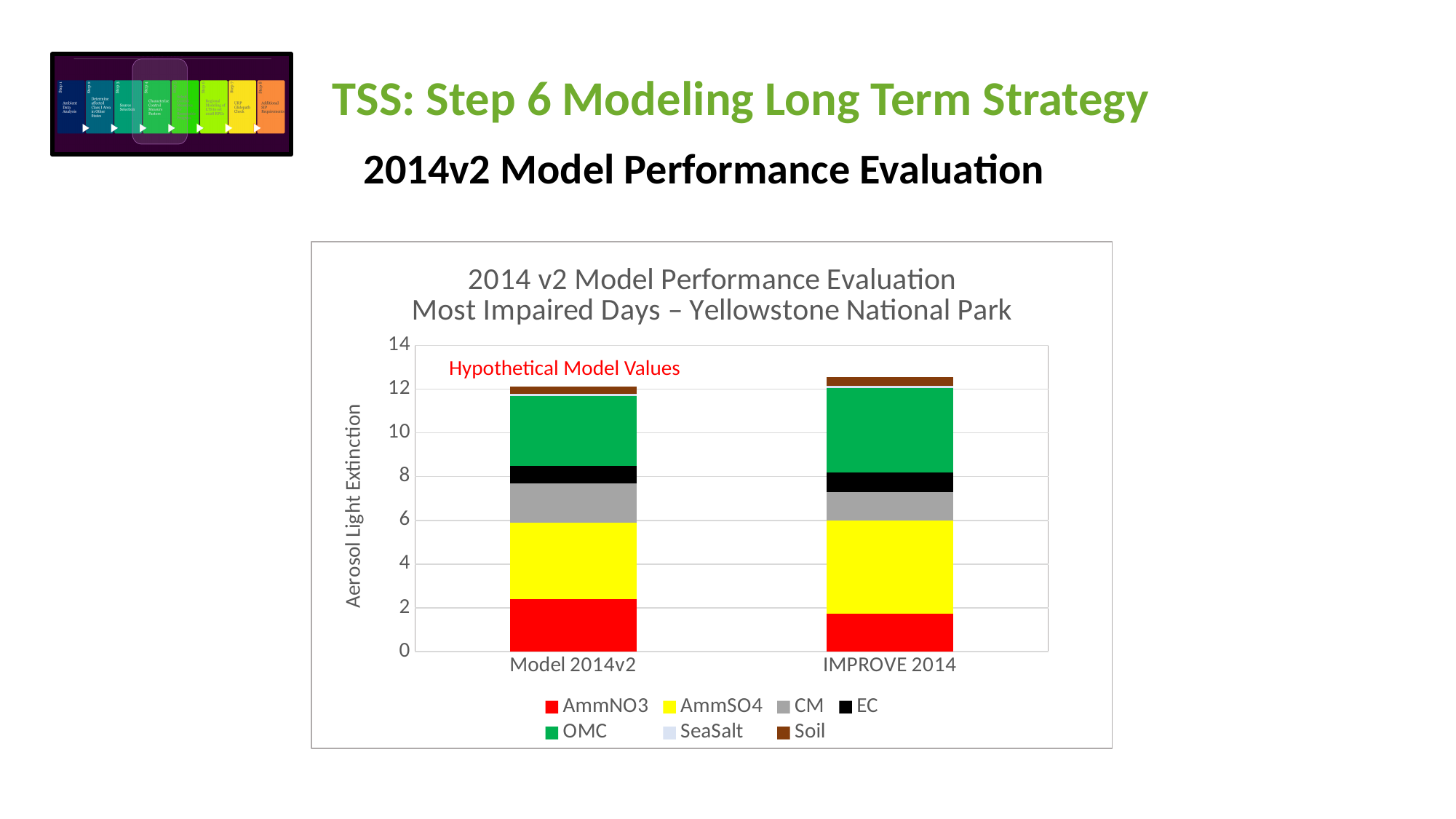
What kind of chart is shown on the slide? Stacked bar chart How many categories are shown on the x axis of the chart? 2 How many series does the chart legend list? 7 Is the total stacked value for Model 2014v2 greater or less than 14? less Is the total stacked value for IMPROVE 2014 greater or less than 10? greater Is the AmmNO3 value for IMPROVE 2014 greater or less than 2? less What is the label of the y axis of the chart? Aerosol Light Extinction Which category has the larger AmmNO3 value, Model 2014v2 or IMPROVE 2014? Model 2014v2 What red annotation text appears inside the chart area? Hypothetical Model Values